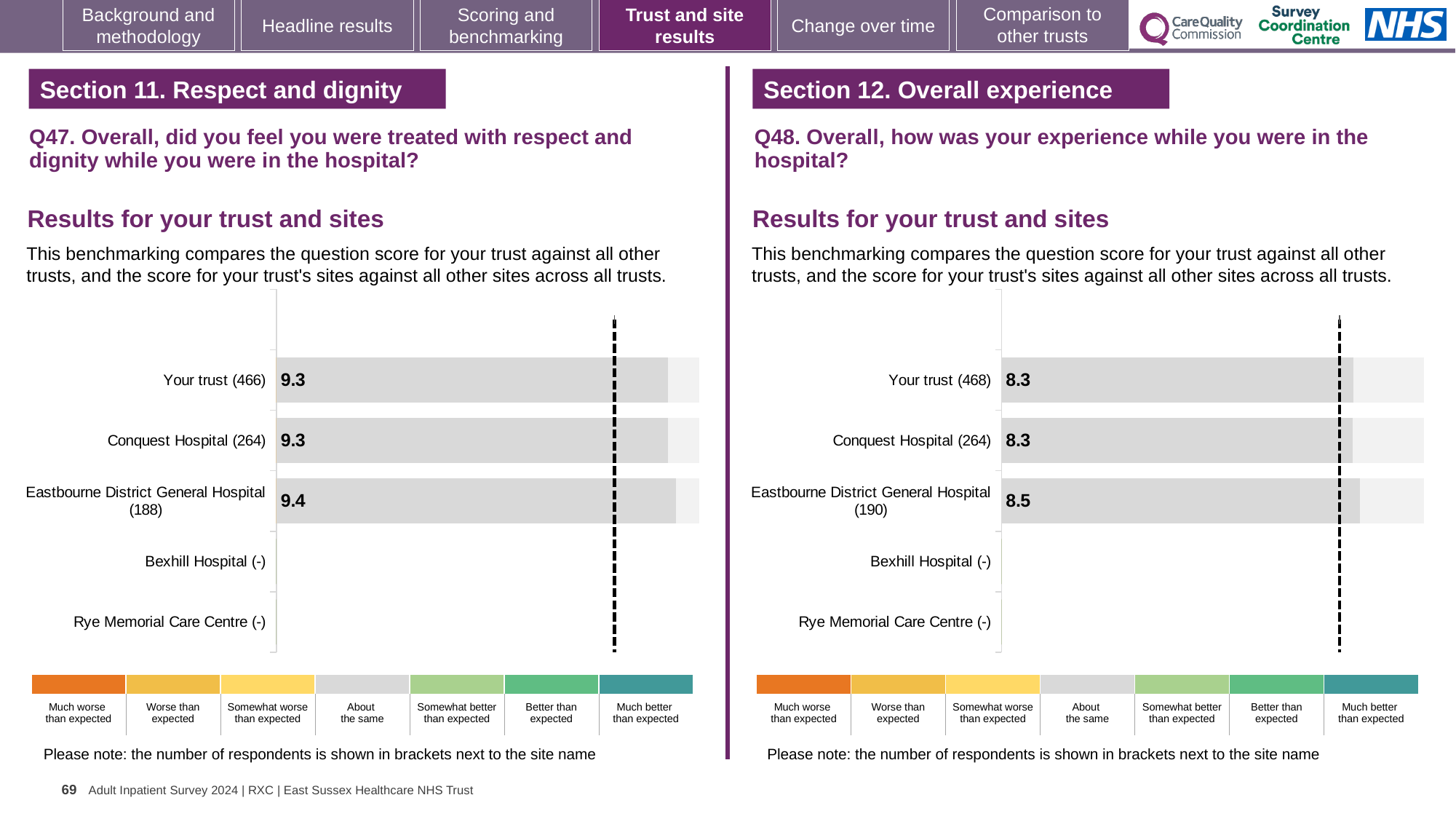
In the Q47 chart on the left, how many respondents are shown in brackets for Conquest Hospital? 264 In the Q48 chart on the right, what is the score for Conquest Hospital? 8.3 In the Q48 chart on the right, what is the difference between the scores for Eastbourne District General Hospital and Your trust? 0.2 In the Q48 chart on the right, how many respondents are shown in brackets for Your trust? 468 In the Q47 chart on the left, which is larger: the score for Eastbourne District General Hospital or the score for Your trust? Eastbourne District General Hospital In the Q47 chart on the left, what is the score for Eastbourne District General Hospital? 9.4 In the Q48 chart on the right, what is the score for Eastbourne District General Hospital? 8.5 In the Q48 chart on the right, which site has the highest score? Eastbourne District General Hospital What kind of chart is used for the Q47 results on the left? Bar chart In the Q47 chart on the left, what is the score for Your trust? 9.3 How many site rows (including Your trust) are listed in the Q48 chart on the right? 5 In the Q47 chart on the left, what is the difference between the scores for Eastbourne District General Hospital and Conquest Hospital? 0.1